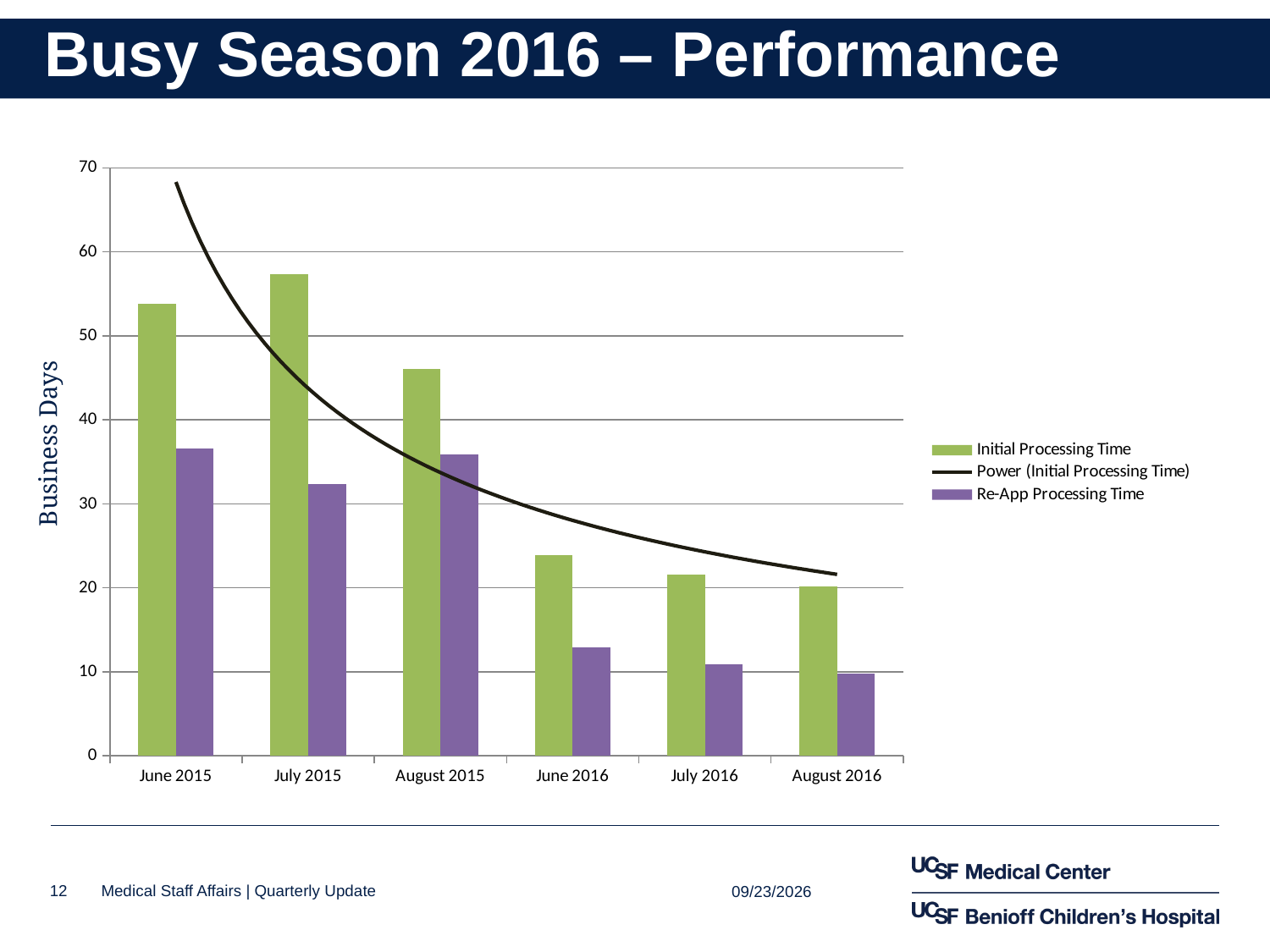
Is the Re-App Processing Time for June 2016 greater or less than 10? greater In June 2015, which is larger: Initial Processing Time or Re-App Processing Time? Initial Processing Time Is the Initial Processing Time for August 2015 greater or less than 50? less What kind of chart is shown on the slide? Bar chart Which category has the highest Initial Processing Time? July 2015 Is the Re-App Processing Time for July 2015 greater or less than 30? greater How many series does the legend list? 3 How many categories are shown on the x axis? 6 What is the label on the vertical axis? Business Days Does the Initial Processing Time generally rise or fall from June 2015 to August 2016? Fall